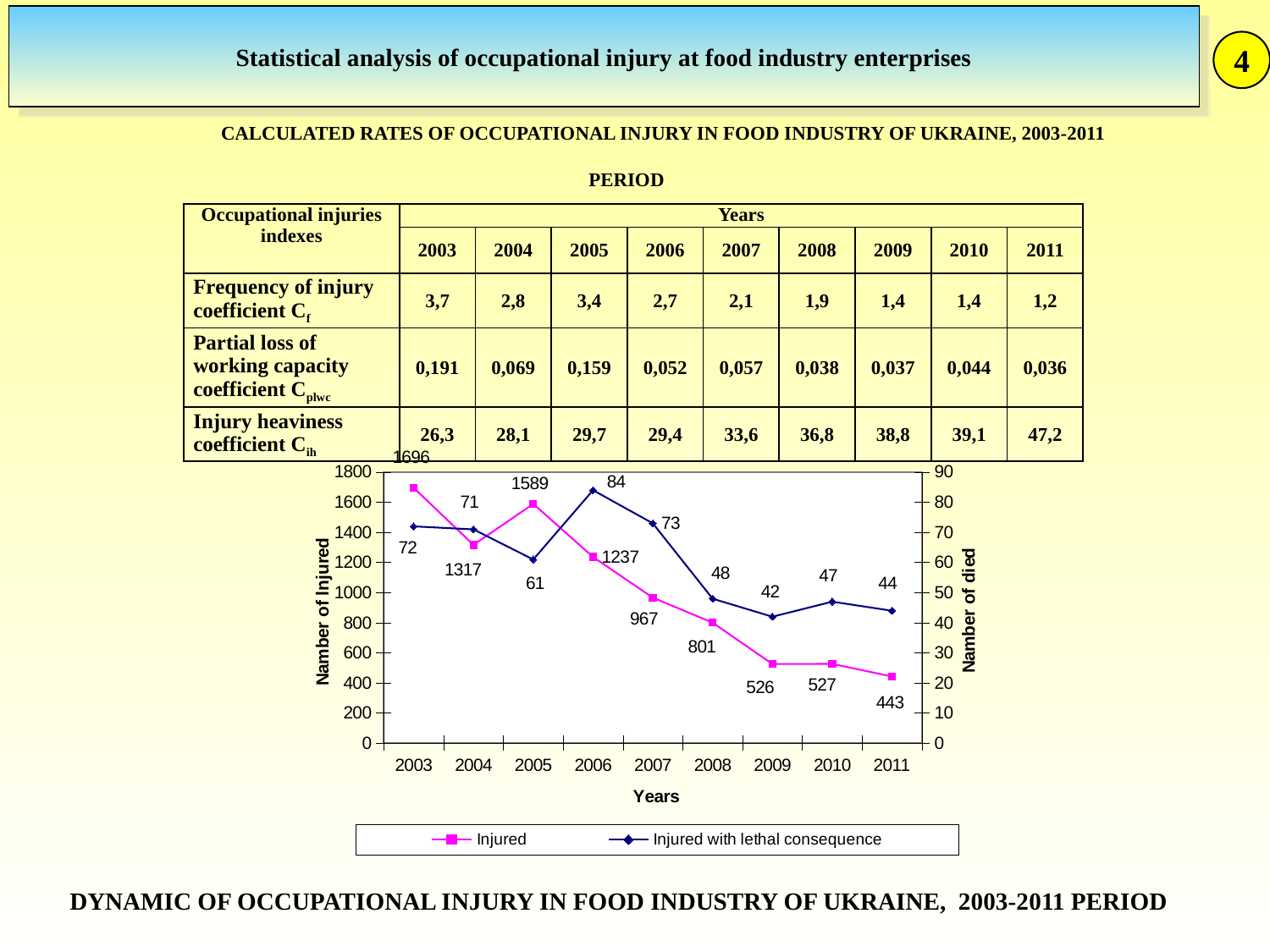
How many series does the chart legend list? 2 In which year is the 'Injured' series at its highest? 2003 What is the difference between the number of injured in 2003 and in 2011? 1253 What is the number of injured in 2003 according to the chart? 1696 What is the value for 'Injured with lethal consequence' in 2006? 84 Which year has more injured with lethal consequence, 2007 or 2008? 2007 Does the 'Injured' series generally rise or fall from 2003 to 2011? fall What is the label of the right-hand vertical axis of the chart? Namber of died What type of chart is shown on the slide? line chart What is the number of injured in 2011? 443 In which year is the 'Injured with lethal consequence' series at its lowest? 2009 How many years are plotted along the x axis of the chart? 9